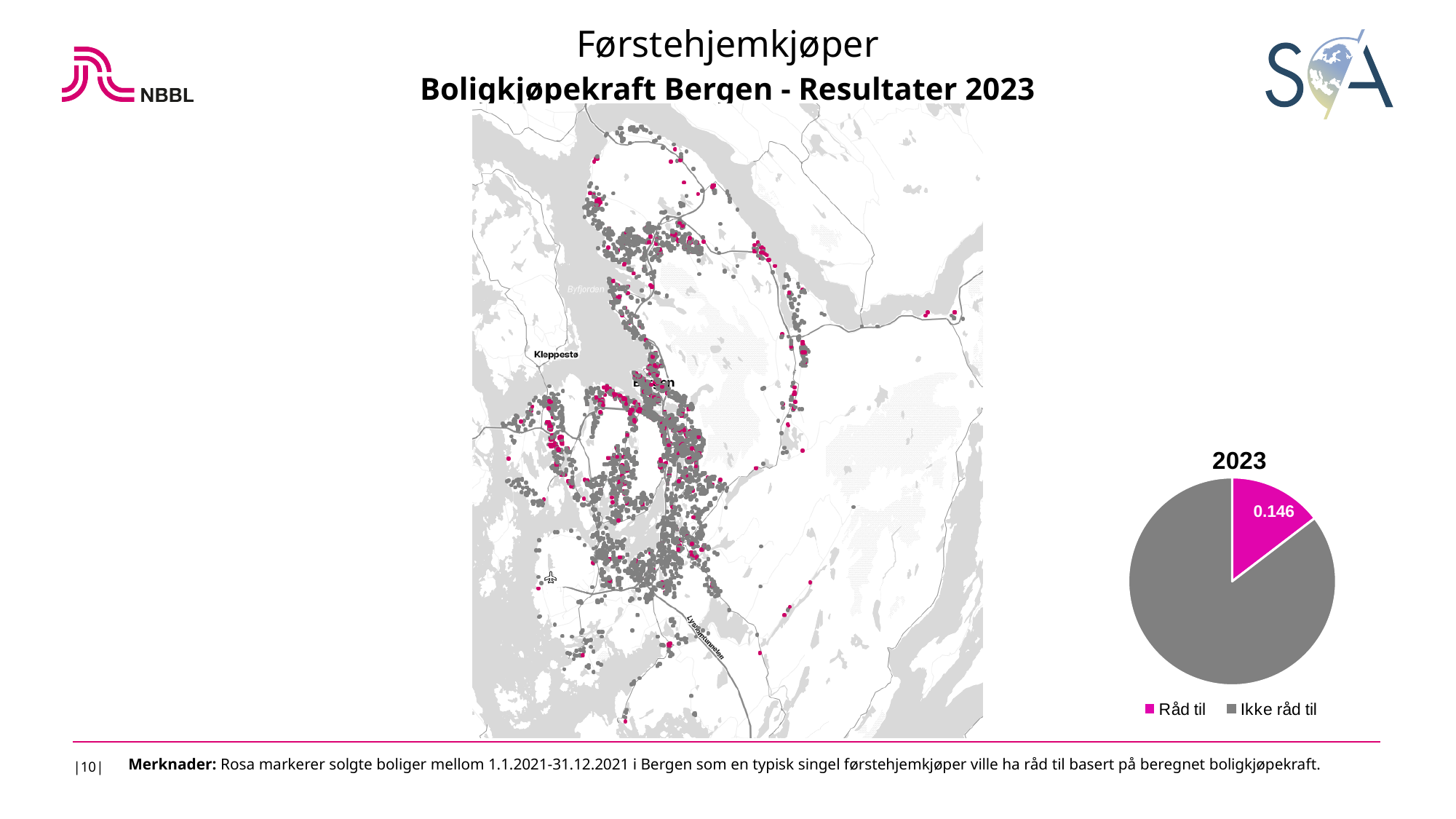
What is the title of the pie chart? 2023 Which slice of the pie chart is the smallest? Råd til How many entries does the pie chart's legend list? 2 In the pie chart, what value is printed on the "Råd til" slice? 0.146 Which slice of the pie chart is the largest? Ikke råd til How many slices does the pie chart have? 2 In the pie chart, which is larger: "Råd til" or "Ikke råd til"? Ikke råd til In the pie chart, what share of the pie does the "Råd til" slice represent? 0.146 What kind of chart is shown on the right side of the slide? Pie chart What colour is the "Råd til" slice in the pie chart? Pink